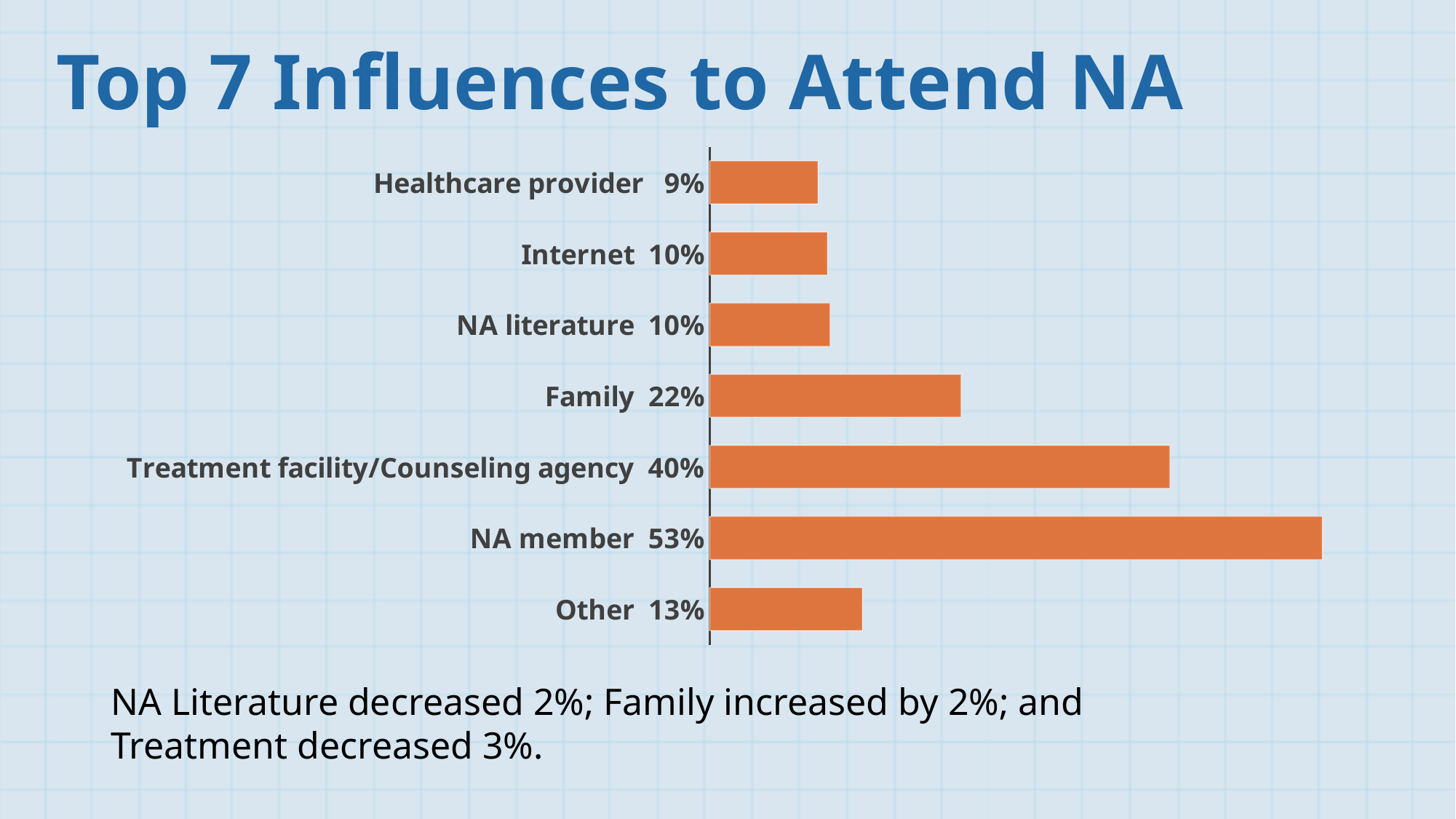
What is the title of the slide? Top 7 Influences to Attend NA What is the value for Treatment facility/Counseling agency? 40% What is the difference between the values for Family and Other? 9% Which category has the lowest value? Healthcare provider Which is larger, the value for Family or the value for Other? Family What is the value for NA member? 53% How many categories are shown in the chart? 7 What is the value for Other? 13% What is the difference between the values for NA member and Treatment facility/Counseling agency? 13% What kind of chart is shown on the slide? Bar chart What is the value for Healthcare provider? 9% Which category has the highest value? NA member